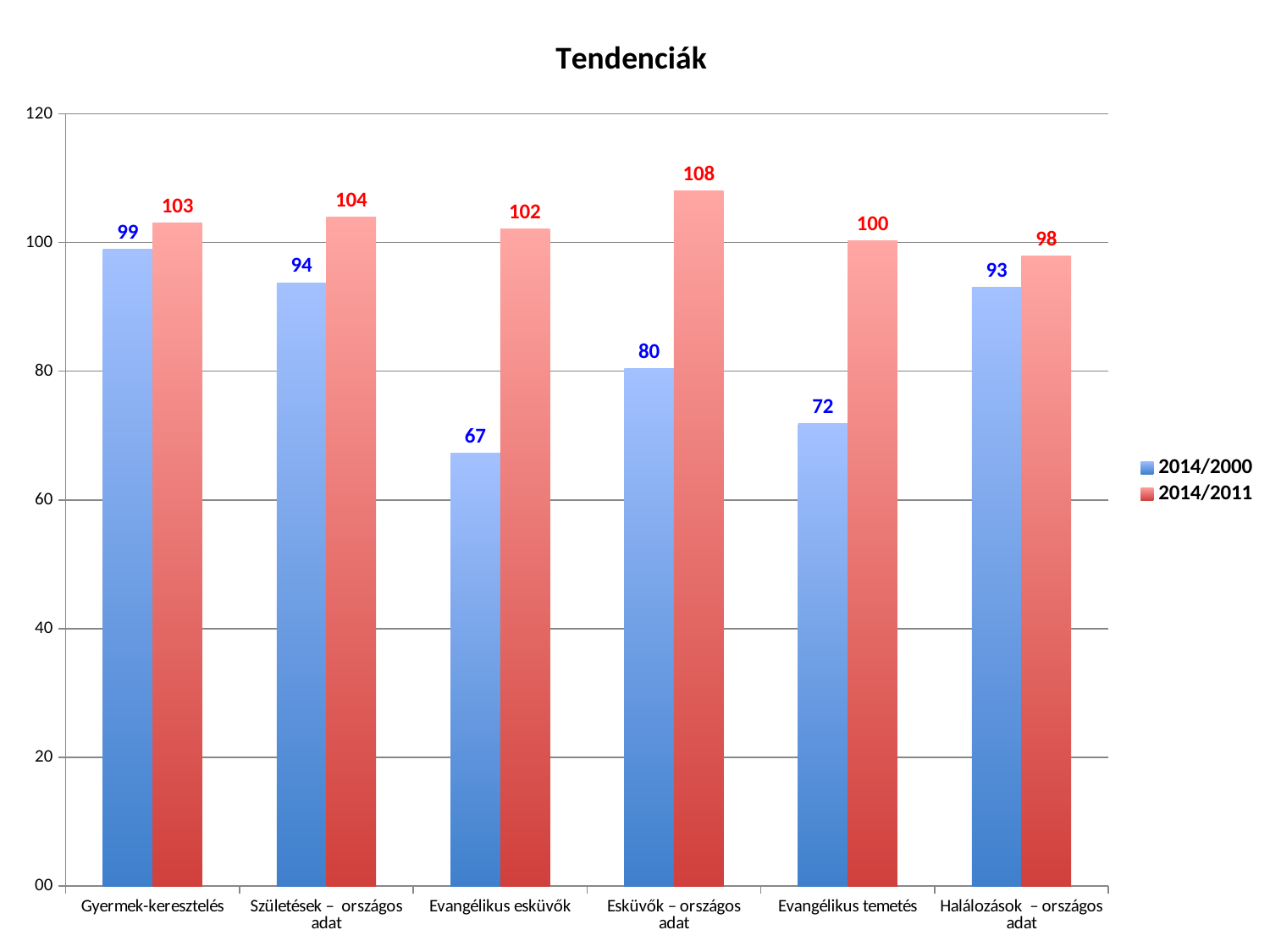
How many categories are shown on the x axis? 6 Which category has the lowest 2014/2000 value? Evangélikus esküvők Which is larger for Halálozások – országos adat: the 2014/2000 value or the 2014/2011 value? 2014/2011 What is the difference between the 2014/2011 and 2014/2000 values for Evangélikus esküvők? 35 What kind of chart is this? bar chart How many series does the legend list? 2 What is the 2014/2000 value for Evangélikus esküvők? 67 What is the difference between the 2014/2000 values for Gyermek-keresztelés and Evangélikus temetés? 27 What is the 2014/2011 value for Esküvők – országos adat? 108 Which category has the highest 2014/2011 value? Esküvők – országos adat What is the title of the chart? Tendenciák What is the 2014/2011 value for Evangélikus temetés? 100